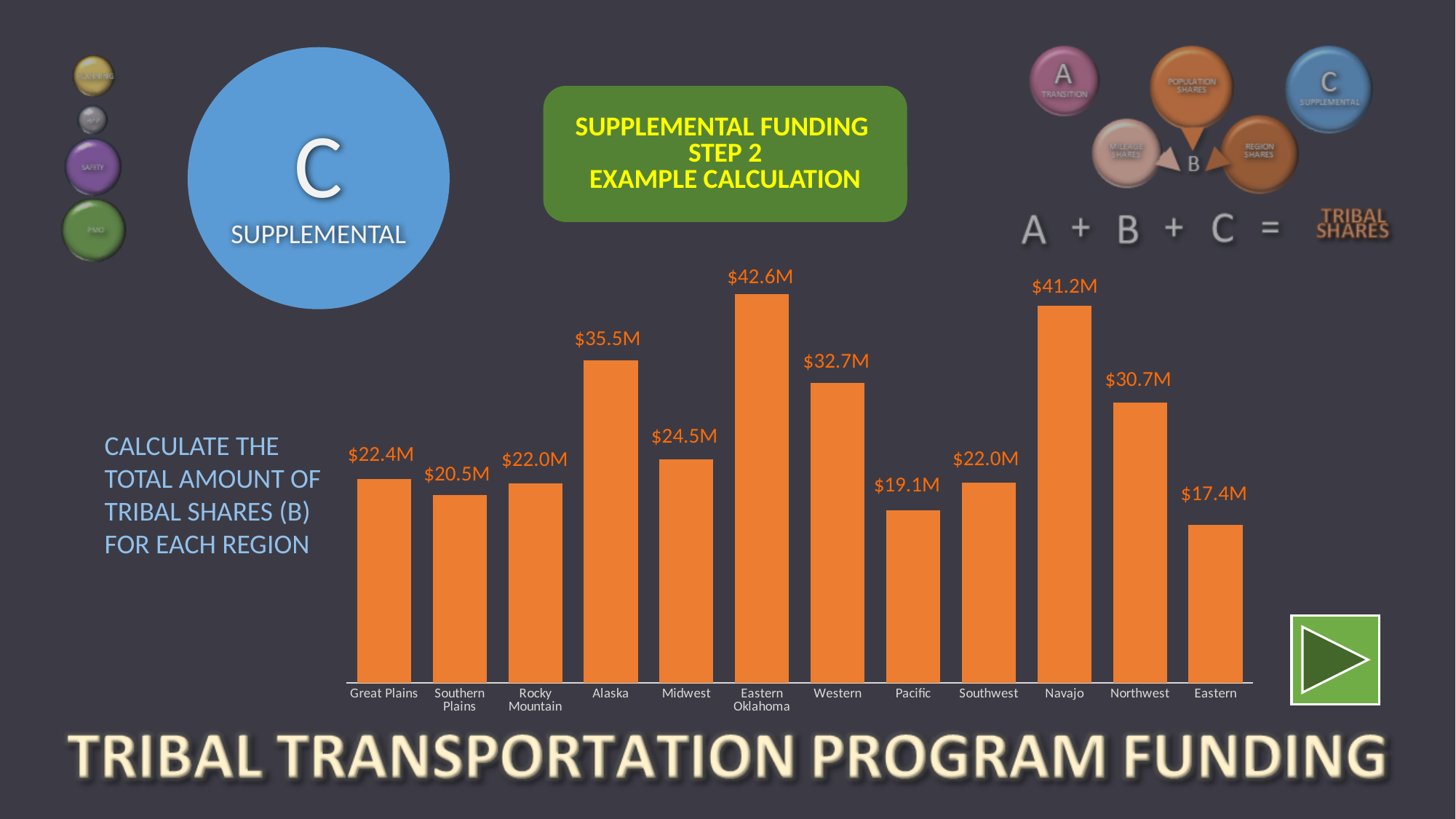
What is the value for Pacific? $19.1M Which is larger, the value for Northwest or the value for Great Plains? Northwest What is the value for Navajo? $41.2M What kind of chart is shown on the slide? Bar chart What is the difference between the values for Alaska and Western? $2.8M Which region has the lowest value? Eastern How many regions are shown in the chart? 12 Which is larger, the value for Navajo or the value for Alaska? Navajo Which region has the highest value? Eastern Oklahoma What is the difference between the values for Eastern Oklahoma and Navajo? $1.4M What is the value for Midwest? $24.5M What is the value for Eastern Oklahoma? $42.6M